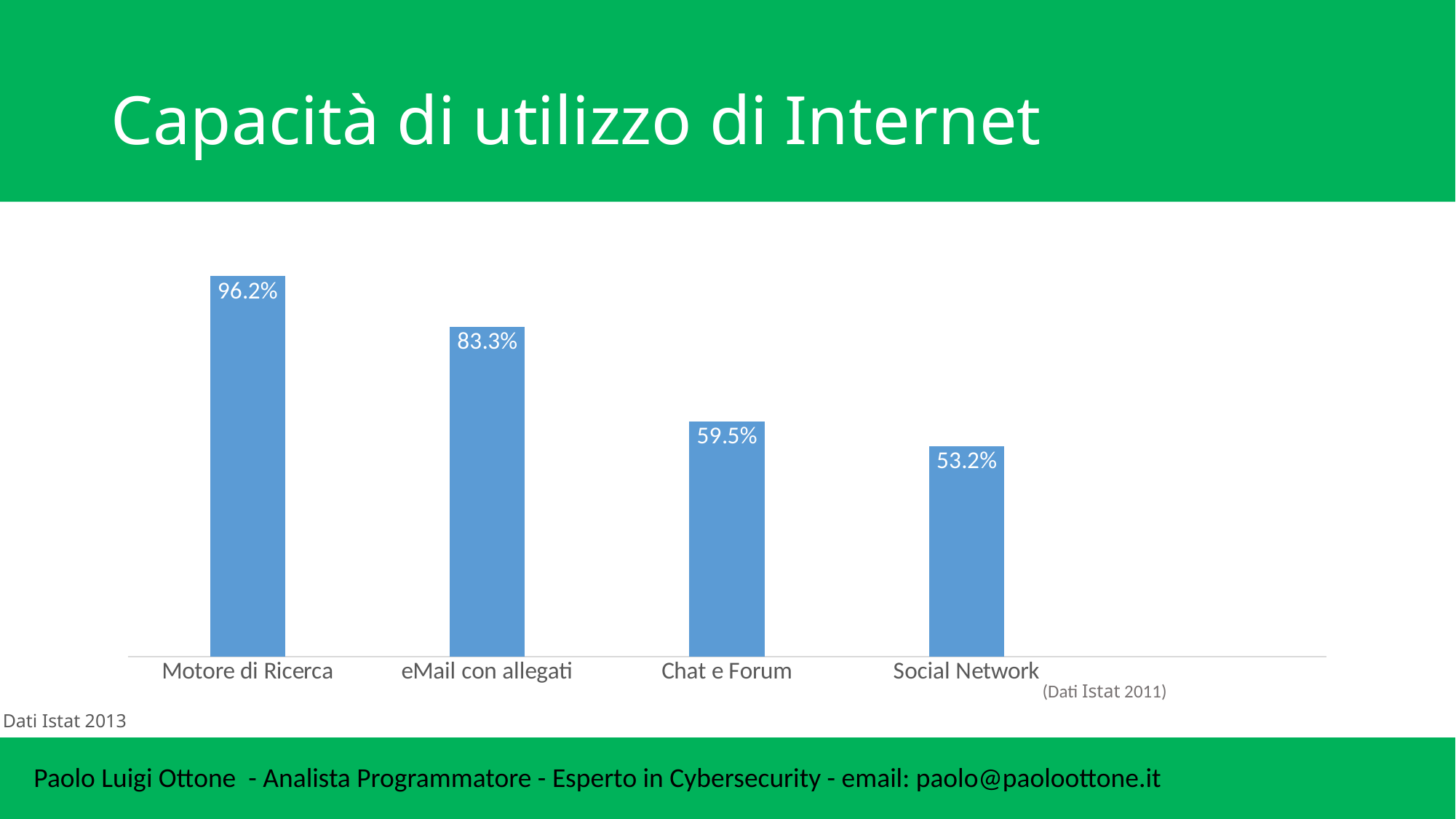
What is the difference between the values for Chat e Forum and Social Network? 6.3% What is the difference between the values for Motore di Ricerca and eMail con allegati? 12.9% Which category has the highest value? Motore di Ricerca Which is larger, the value for eMail con allegati or the value for Chat e Forum? eMail con allegati What is the value for Social Network? 53.2% Which category has the lowest value? Social Network What is the value for Motore di Ricerca? 96.2% Do the values rise or fall from left to right along the x axis? Fall What kind of chart is shown on the slide? Bar chart What is the value for eMail con allegati? 83.3% What is the value for Chat e Forum? 59.5% How many categories are shown in the chart? 4